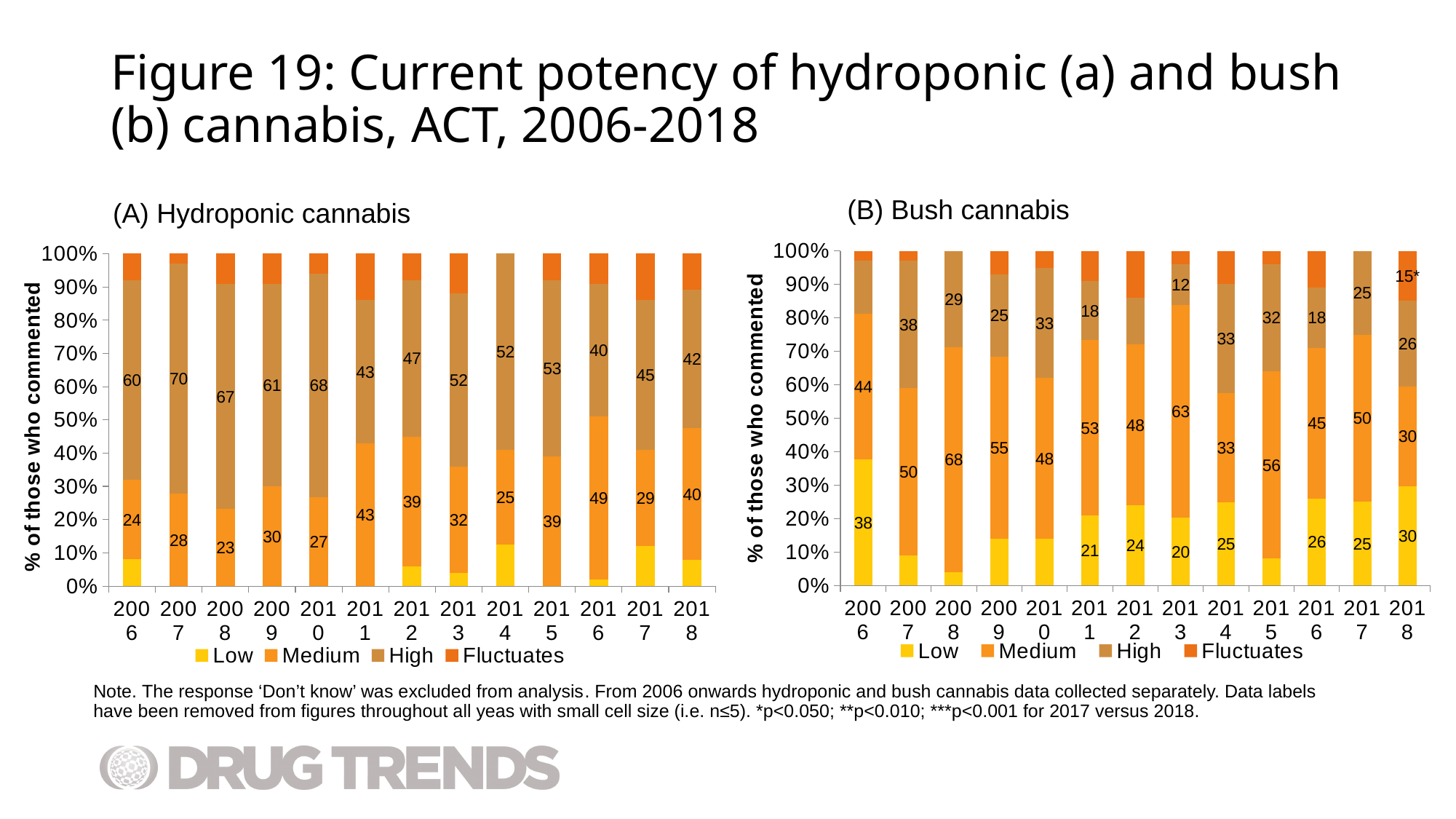
What is the y-axis label of the Bush cannabis chart? % of those who commented In the Bush cannabis chart, which year has the lowest labelled High value? 2013 In the Hydroponic cannabis chart, what is the Medium value for 2016? 49 In the Hydroponic cannabis chart, which year has the highest High value? 2007 What type of chart is the Hydroponic cannabis chart? Stacked bar chart In the Bush cannabis chart, what is the Low value for 2006? 38 How many years are shown on the x axis of the Bush cannabis chart? 13 In the Hydroponic cannabis chart, what percentage of respondents rated potency as High in 2007? 70 How many series does the legend of the Hydroponic cannabis chart list? 4 In the Bush cannabis chart, what is the Medium value for 2013? 63 In the Bush cannabis chart, which is larger in 2008: the Medium value or the High value? Medium In the Hydroponic cannabis chart, what is the difference between the High values for 2007 and 2018? 28